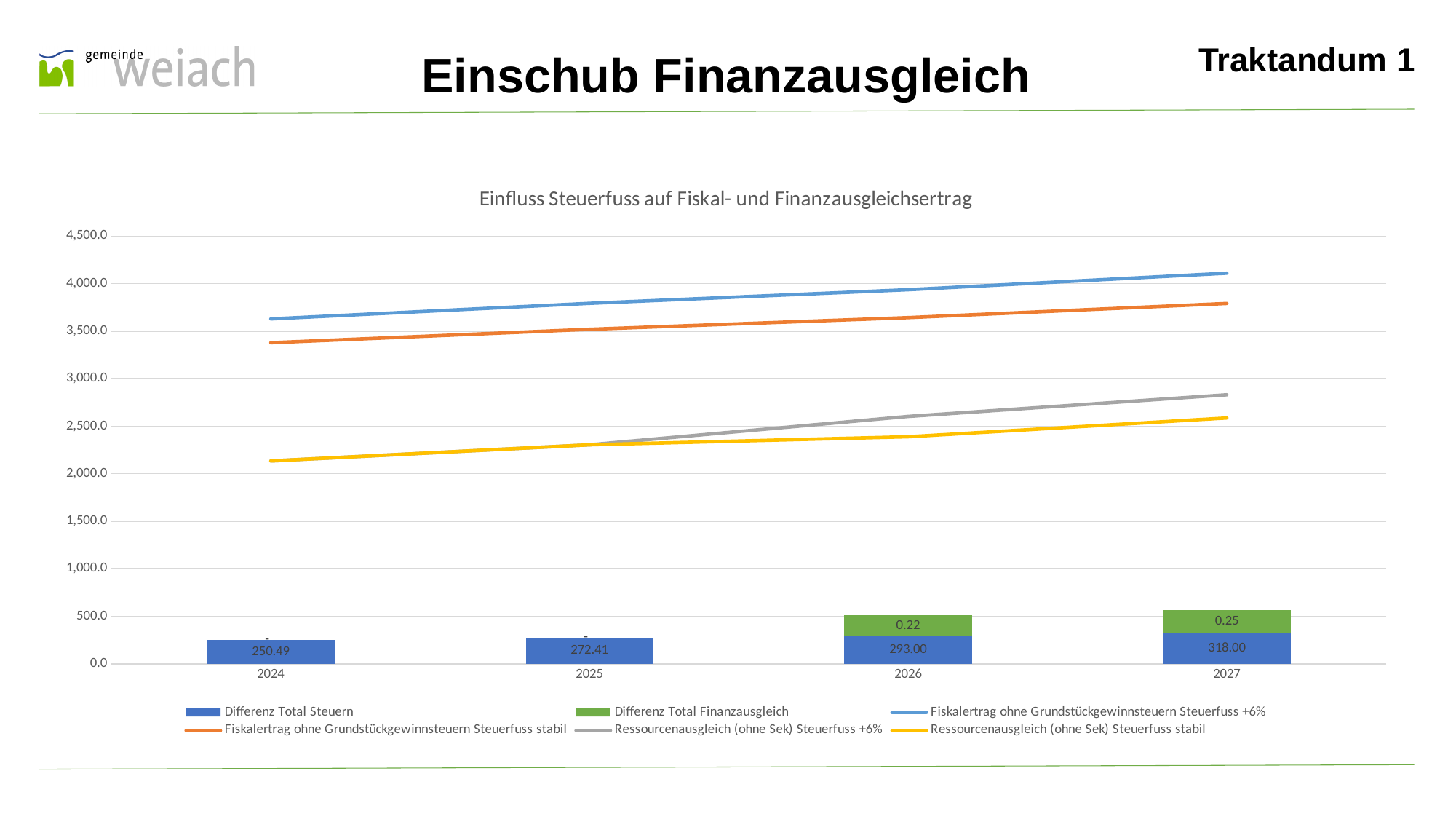
What is the value of Differenz Total Finanzausgleich for 2027? 0.25 In which year is Differenz Total Steuern highest? 2027 What is the value of Differenz Total Steuern for 2024? 250.49 How many series does the legend list? 6 Does the line for Ressourcenausgleich (ohne Sek) Steuerfuss stabil rise or fall from 2024 to 2027? rise In which year is Differenz Total Steuern lowest? 2024 How many years are shown on the x axis? 4 Is the value of Fiskalertrag ohne Grundstückgewinnsteuern Steuerfuss +6% for 2027 greater or less than 4,000.0? greater What is the difference between Differenz Total Steuern in 2027 and in 2024? 67.51 What is the value of Differenz Total Steuern for 2027? 318.00 What is the title of the chart? Einfluss Steuerfuss auf Fiskal- und Finanzausgleichsertrag What is the value of Differenz Total Finanzausgleich for 2026? 0.22